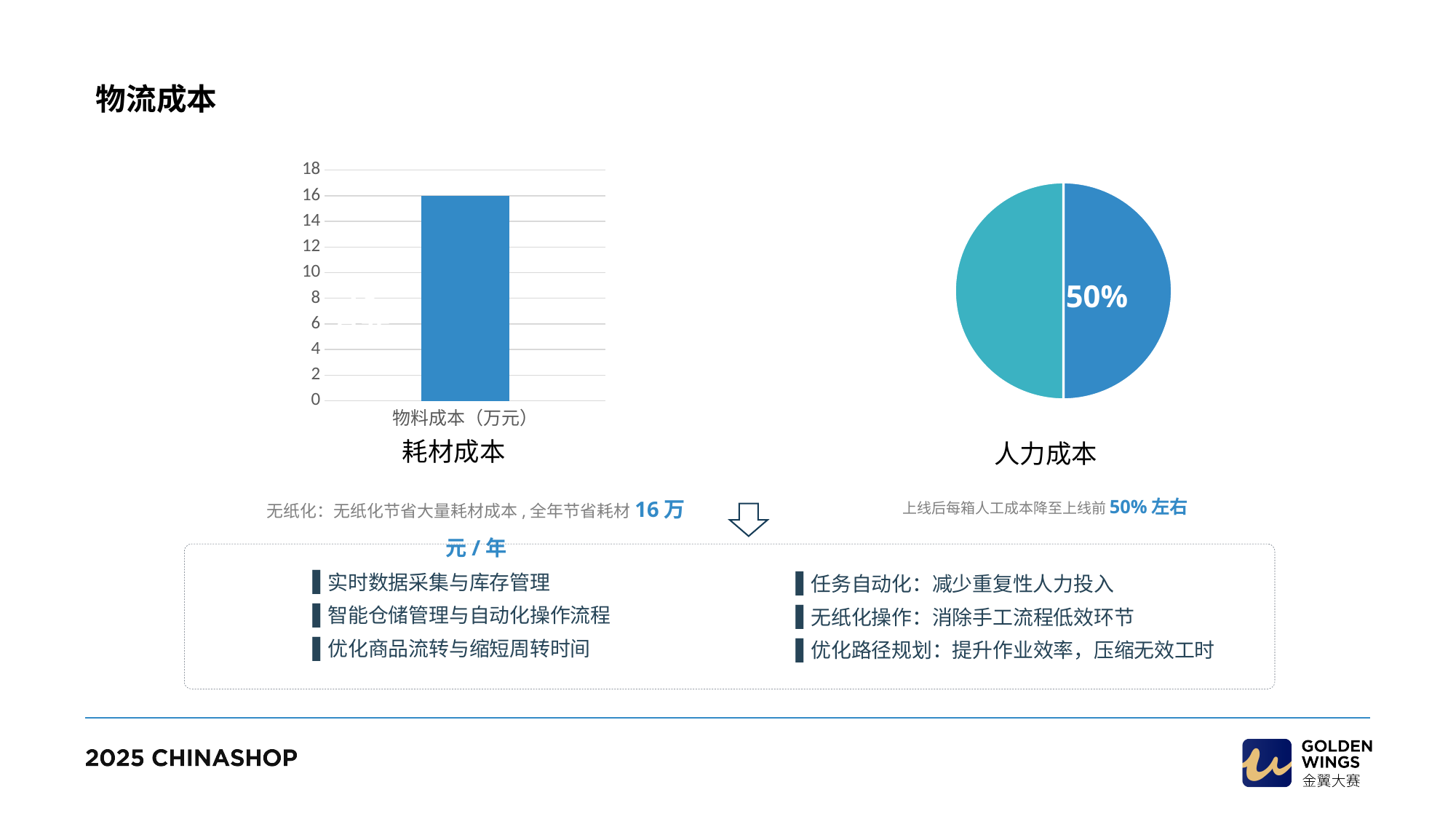
On the left bar chart (耗材成本), is the value for 物料成本（万元） greater or less than 10? greater What is the category label on the x axis of the left bar chart (耗材成本)? 物料成本（万元） What kind of chart is the left chart under 耗材成本? bar chart On the left bar chart (耗材成本), what is the highest value shown on the vertical axis? 18 What kind of chart is the right chart under 人力成本? pie chart On the left bar chart (耗材成本), what is the value of the bar for 物料成本（万元）? 16 On the pie chart under 人力成本, what share is shown by the data label on the dark blue slice? 50% How many slices does the pie chart under 人力成本 have? 2 How many bars are plotted on the left bar chart (耗材成本)? 1